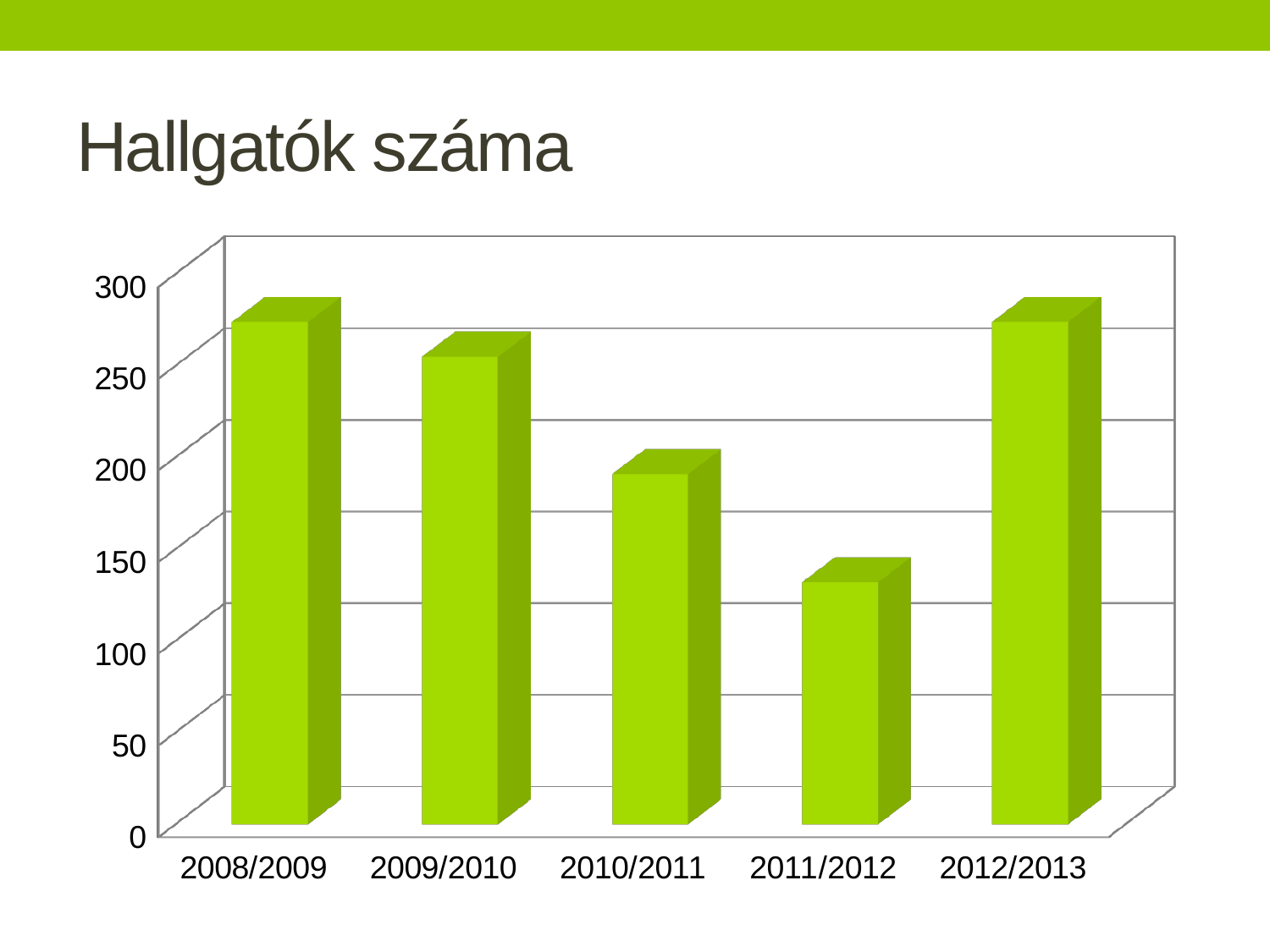
Which academic year has the lowest value in the chart? 2011/2012 Which is larger, the value for 2008/2009 or the value for 2010/2011? 2008/2009 Is the value for 2012/2013 greater or less than 250? greater What is the title of the slide containing the chart? Hallgatók száma Is the value for 2008/2009 greater or less than 250? greater What kind of chart is shown on the slide? bar chart Is the value for 2011/2012 greater or less than 100? greater Do the values rise or fall from 2008/2009 to 2011/2012? fall How many academic years are shown on the x axis of the chart? 5